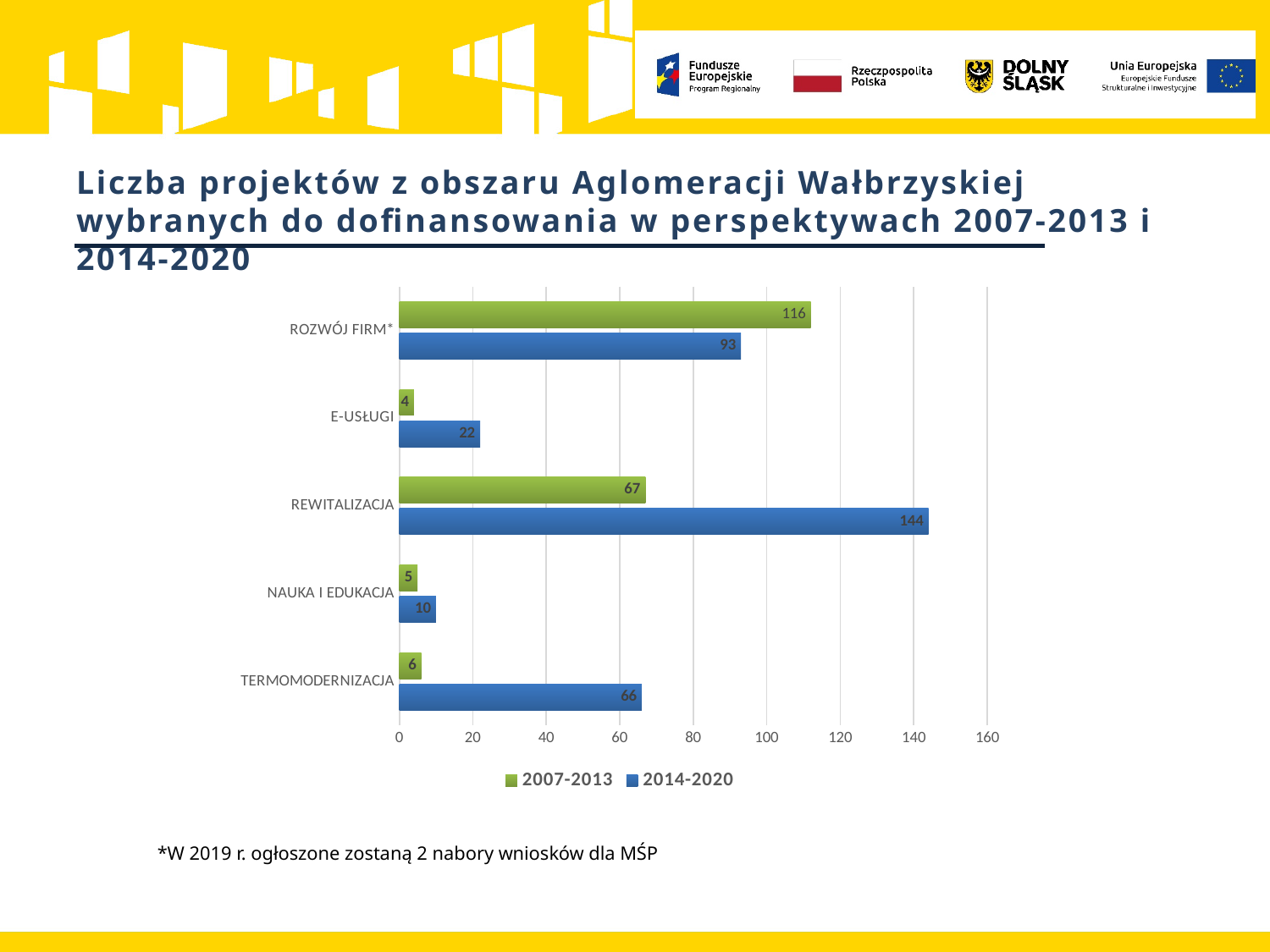
What is the value for E-USŁUGI in the 2014-2020 series? 22 What is the value for REWITALIZACJA in the 2014-2020 series? 144 What is the value for TERMOMODERNIZACJA in the 2007-2013 series? 6 What is the value for ROZWÓJ FIRM* in the 2007-2013 series? 116 How many categories are shown on the chart? 5 What is the difference between the 2014-2020 and 2007-2013 values for REWITALIZACJA? 77 Which category has the highest value in the 2014-2020 series? REWITALIZACJA Which is larger for ROZWÓJ FIRM*: the 2007-2013 value or the 2014-2020 value? 2007-2013 How many series does the legend list? 2 What kind of chart is shown on the slide? bar chart Which category has the lowest value in the 2007-2013 series? E-USŁUGI What colour represents the 2014-2020 series? blue